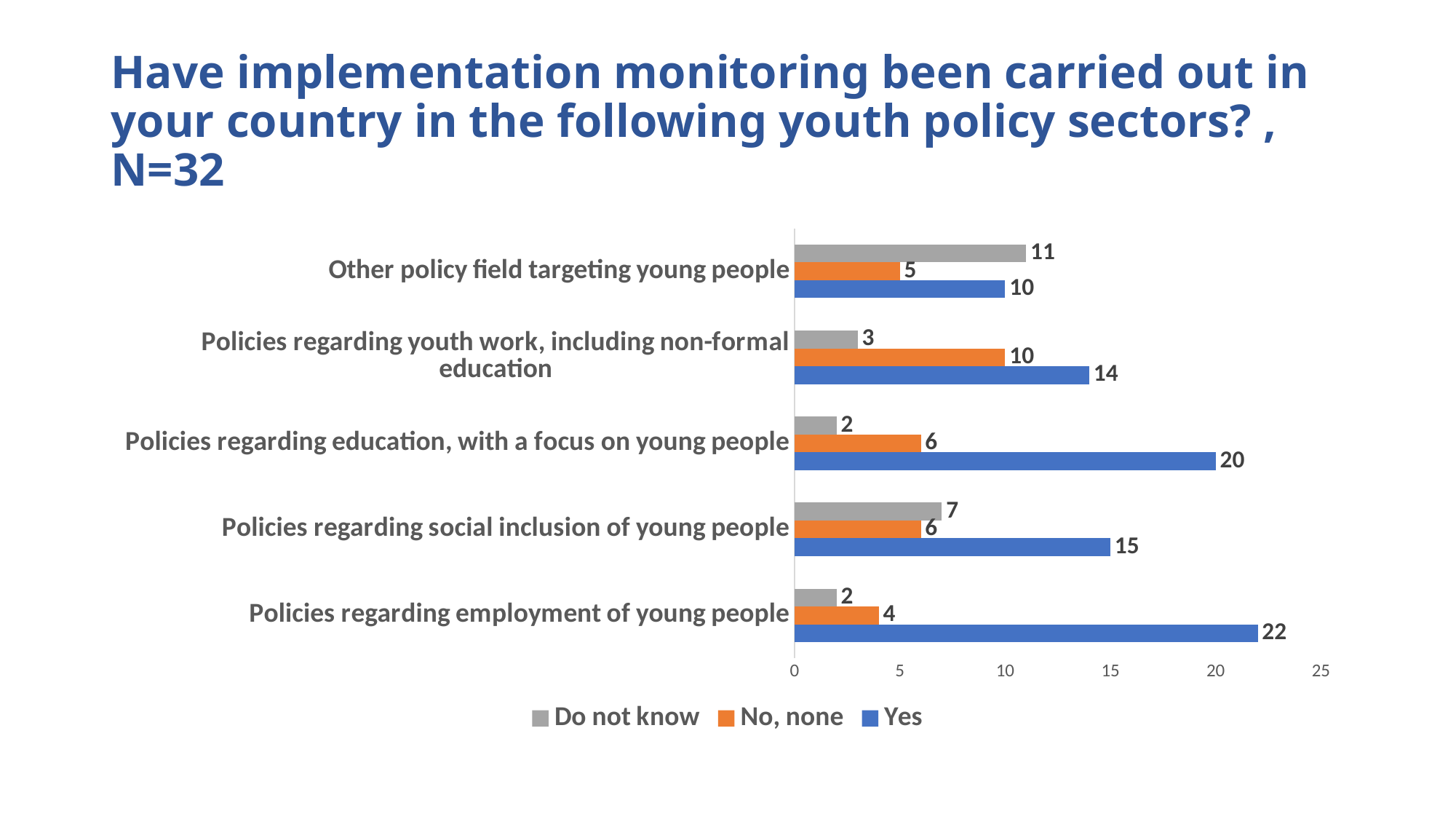
What is the difference between the 'Yes' values for Policies regarding education, with a focus on young people and Policies regarding social inclusion of young people? 5 Is the 'Yes' value for Policies regarding youth work, including non-formal education greater or less than 10? greater What is the 'No, none' value for Policies regarding youth work, including non-formal education? 10 What is the 'Do not know' value for Other policy field targeting young people? 11 What colour represents the 'Yes' series? Blue How many series does the legend list? 3 Which category has the lowest 'Yes' value? Other policy field targeting young people How many policy sector categories are shown on the chart? 5 What is the 'Yes' value for Policies regarding employment of young people? 22 What type of chart is shown on the slide? Bar chart Which category has the highest 'Yes' value? Policies regarding employment of young people Which is larger for Policies regarding social inclusion of young people: 'Do not know' or 'No, none'? Do not know